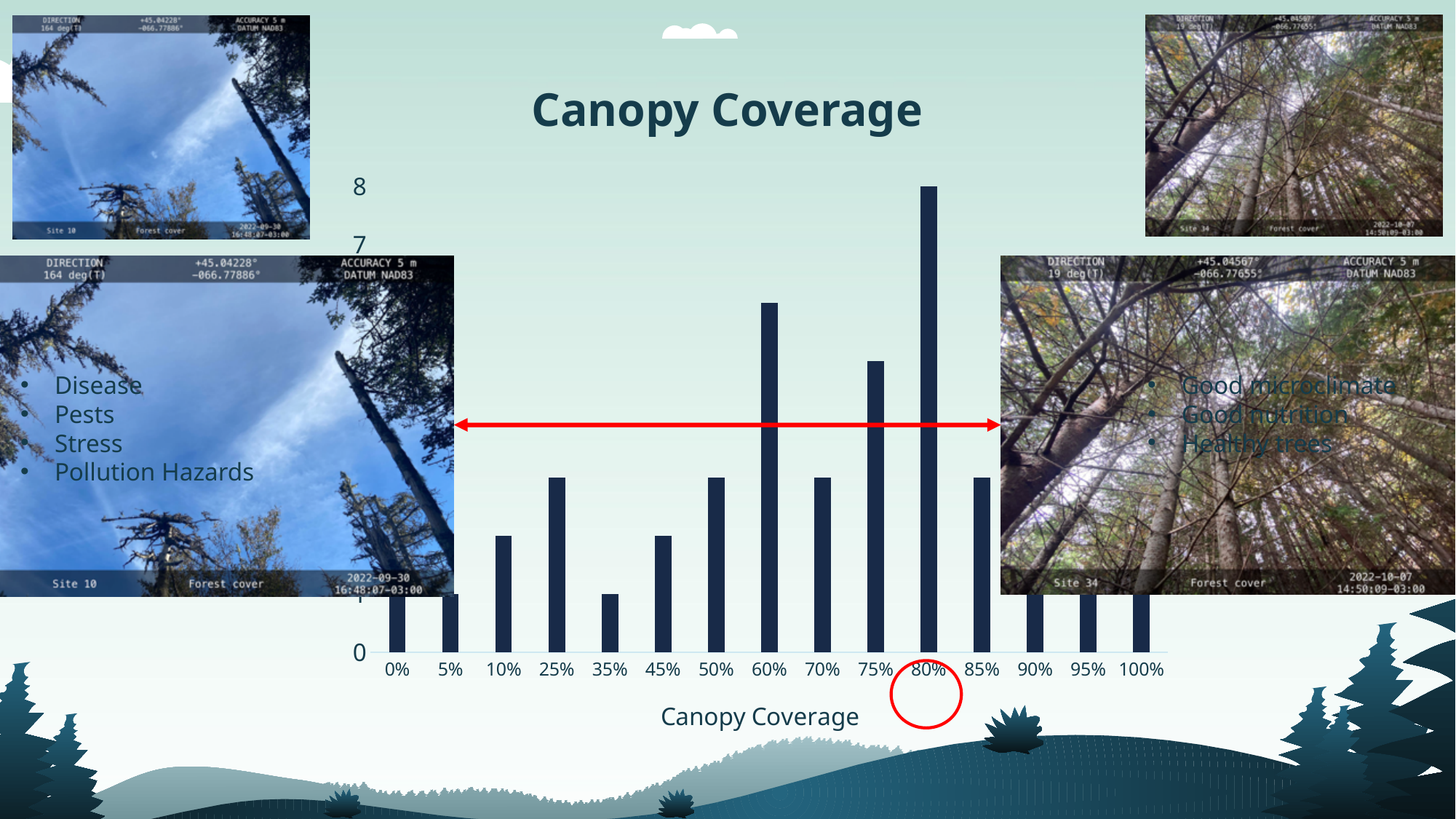
What is the value of the bar for 80% canopy coverage? 8 Which canopy coverage category has the highest bar? 80% Which bar is taller, 60% or 75% canopy coverage? 60% Is the value for 60% canopy coverage greater or less than 7? less Which bar is taller, 25% or 10% canopy coverage? 25% How many categories are shown on the x axis of the chart? 15 What kind of chart is shown on the slide? bar chart Which bar is taller, 35% or 50% canopy coverage? 50% Which x-axis category is circled in red on the chart? 80% Is the value for 80% canopy coverage greater or less than 7? greater What is the title of the chart? Canopy Coverage Is the value for 75% canopy coverage greater or less than 7? less